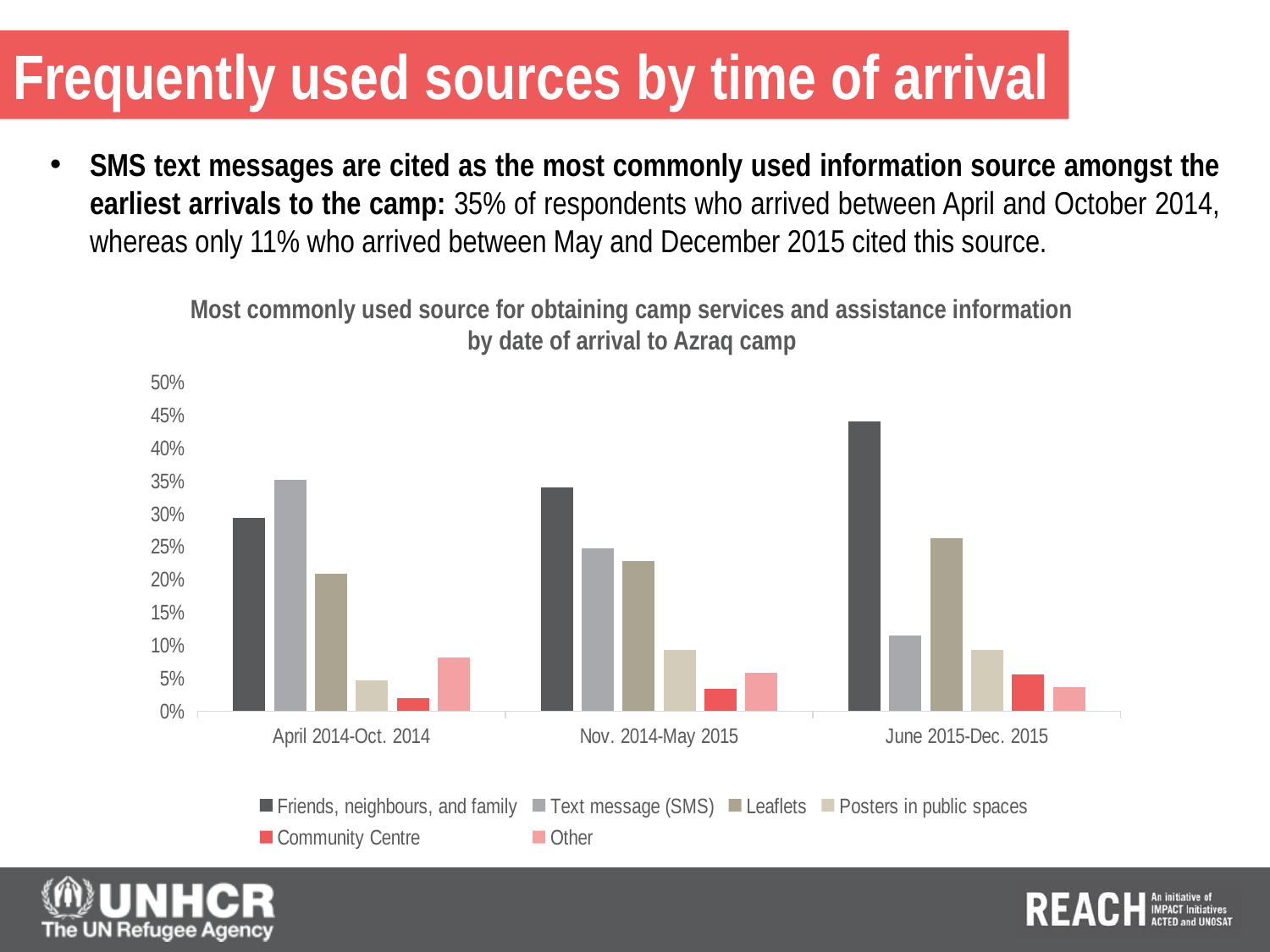
Is the value for Community Centre in April 2014-Oct. 2014 greater or less than 5%? less Which series is shown in red in the legend? Community Centre Is the value for Text message (SMS) in Nov. 2014-May 2015 greater or less than 30%? less What kind of chart is shown on the slide? bar chart For April 2014-Oct. 2014, which is larger: Friends, neighbours, and family or Text message (SMS)? Text message (SMS) Which source has the highest value for June 2015-Dec. 2015? Friends, neighbours, and family Is the value for Friends, neighbours, and family in June 2015-Dec. 2015 greater or less than 40%? greater Does the value for Friends, neighbours, and family rise or fall across the arrival periods from left to right? rise How many arrival-period categories are shown on the x axis? 3 How many series does the legend list? 6 Which source has the lowest value for April 2014-Oct. 2014? Community Centre What percentage of respondents who arrived April 2014-Oct. 2014 cited Text message (SMS)? 35%